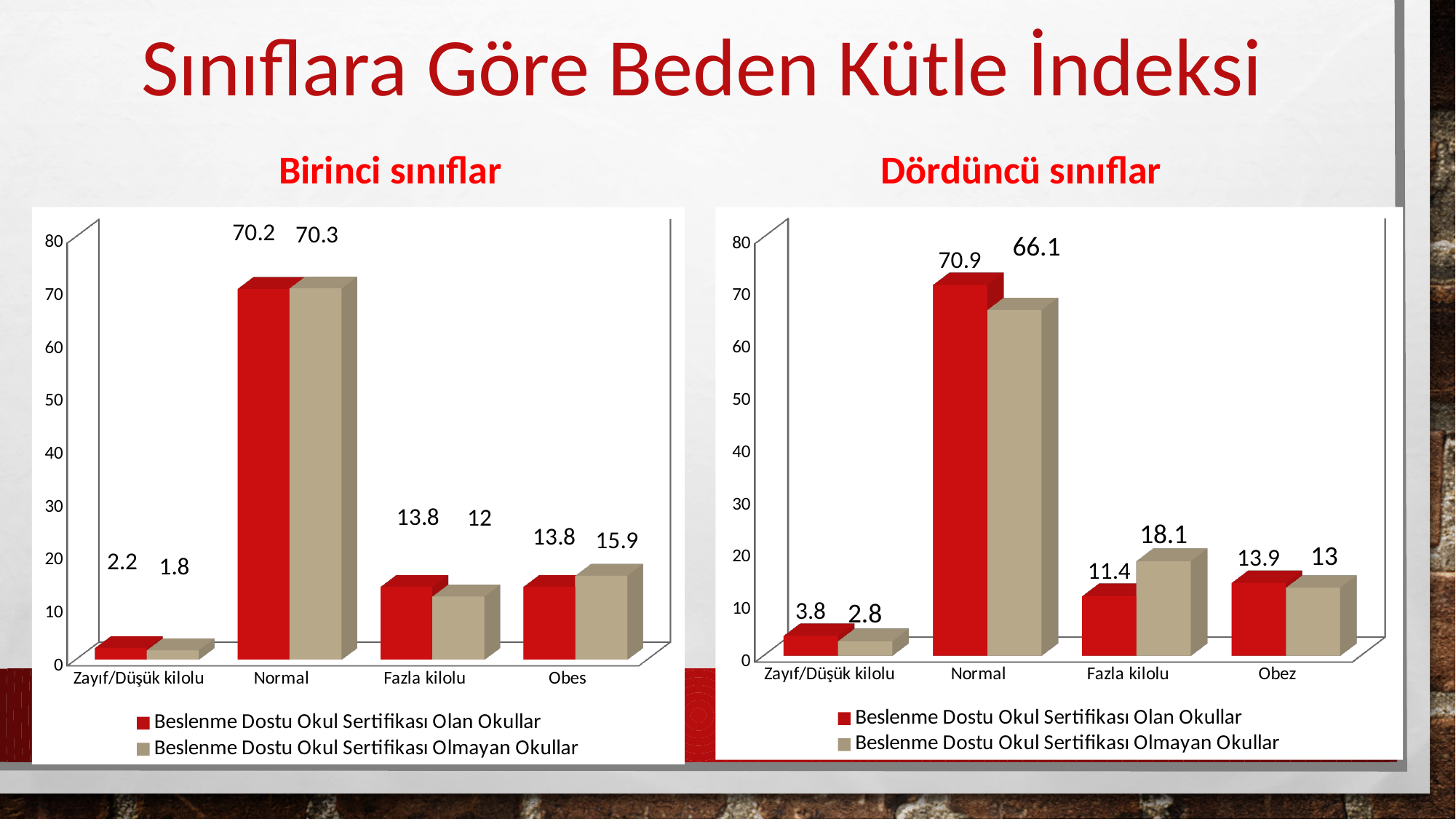
In the 'Birinci sınıflar' chart, what is the value for Obes in the 'Beslenme Dostu Okul Sertifikası Olmayan Okullar' series? 15.9 In the 'Birinci sınıflar' chart, what is the difference between the two series' values for Obes? 2.1 In the 'Dördüncü sınıflar' chart, for Fazla kilolu, which series has the larger value? Beslenme Dostu Okul Sertifikası Olmayan Okullar How many series does the legend of the 'Dördüncü sınıflar' chart list? 2 In the 'Dördüncü sınıflar' chart, what is the value for Zayıf/Düşük kilolu in the 'Beslenme Dostu Okul Sertifikası Olan Okullar' series? 3.8 In the 'Birinci sınıflar' chart, which category has the lowest value in the 'Beslenme Dostu Okul Sertifikası Olmayan Okullar' series? Zayıf/Düşük kilolu In the 'Birinci sınıflar' chart, what is the value for Normal in the 'Beslenme Dostu Okul Sertifikası Olan Okullar' series? 70.2 In the 'Dördüncü sınıflar' chart, what is the value for Fazla kilolu in the 'Beslenme Dostu Okul Sertifikası Olmayan Okullar' series? 18.1 How many categories are shown on the x axis of the 'Birinci sınıflar' chart? 4 What kind of chart is the 'Birinci sınıflar' chart? Bar chart In the 'Dördüncü sınıflar' chart, which category has the highest value in the 'Beslenme Dostu Okul Sertifikası Olan Okullar' series? Normal In the 'Dördüncü sınıflar' chart, what is the difference between the two series' values for Normal? 4.8